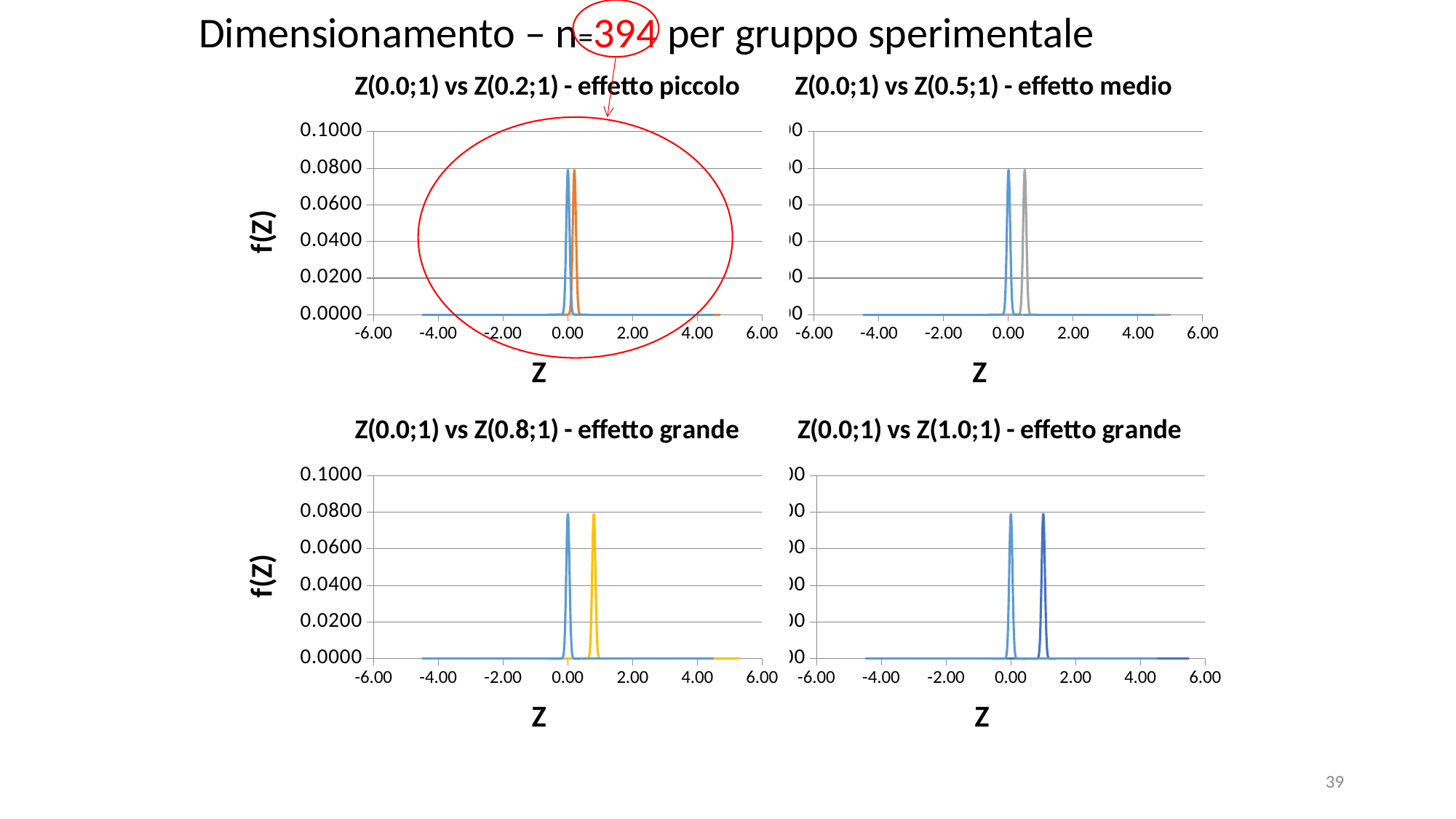
What kind of chart is the top-left chart titled 'Z(0.0;1) vs Z(0.2;1) - effetto piccolo'? line chart What is the title of the top-right chart? Z(0.0;1) vs Z(0.5;1) - effetto medio How many charts are shown on the slide? 4 What label is shown on the y axis of the bottom-left chart? f(Z) In the top-right chart 'Z(0.0;1) vs Z(0.5;1) - effetto medio', is the value of the grey curve at Z = 4.00 greater or less than 0.0200? less In the top-left chart 'Z(0.0;1) vs Z(0.2;1) - effetto piccolo', is the peak value of the blue curve greater or less than 0.0600? greater In the bottom-right chart 'Z(0.0;1) vs Z(1.0;1) - effetto grande', is the peak of the dark blue curve greater or less than 0.0400? greater In the bottom-left chart 'Z(0.0;1) vs Z(0.8;1) - effetto grande', which curve peaks further to the right along the x axis, the blue one or the yellow one? the yellow one How many curves are plotted in the bottom-left chart titled 'Z(0.0;1) vs Z(0.8;1) - effetto grande'? 2